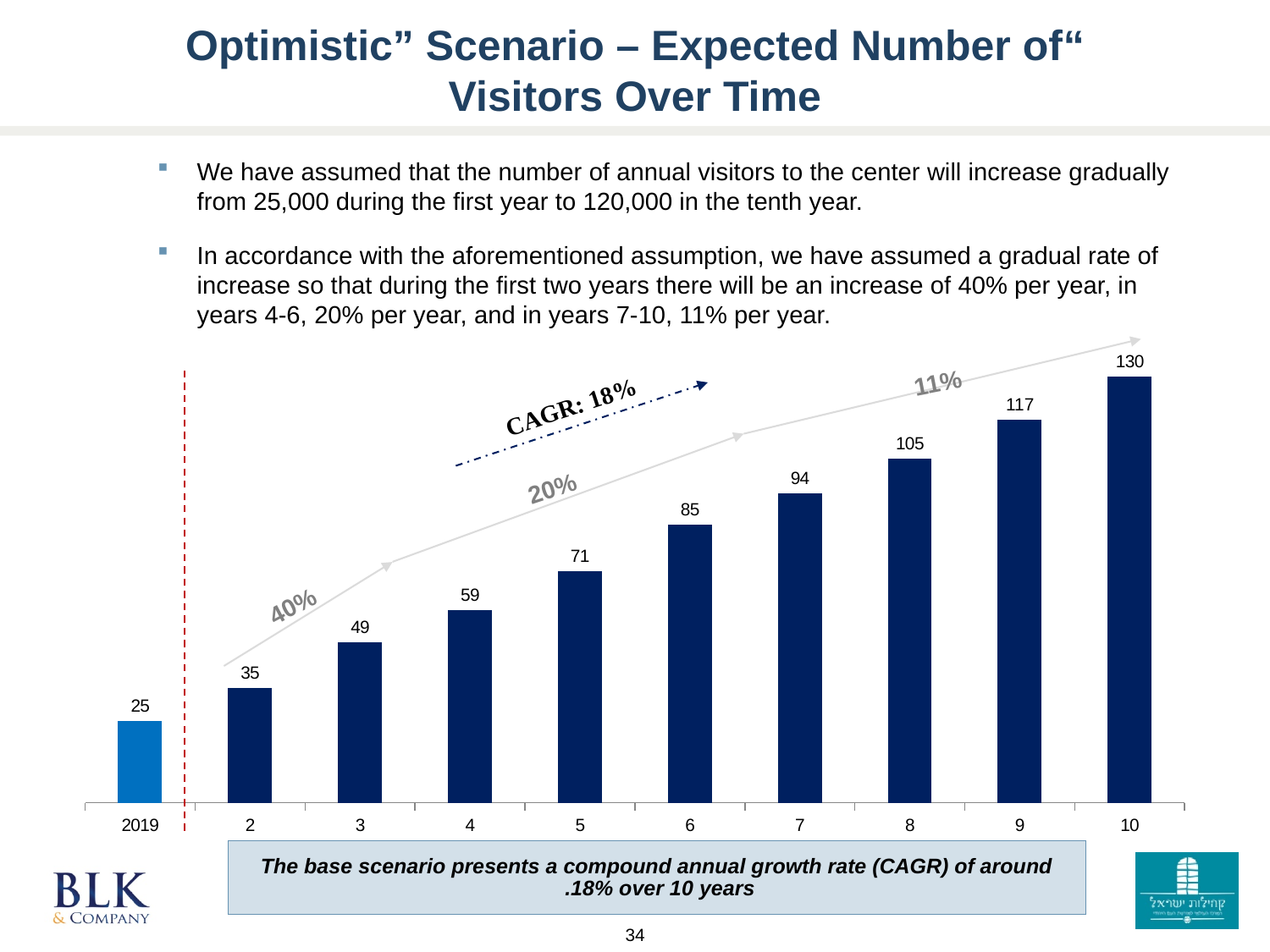
What value is shown for year 5? 71 What CAGR is labelled on the dashed arrow above the bars? CAGR: 18% Which year has the highest value on the chart? 10 Which is larger, the value for year 4 or the value for year 3? Year 4 What is the expected number of visitors (in thousands) shown for 2019? 25 Which category has the lowest value on the chart? 2019 Do the values rise or fall from 2019 to year 10? Rise What is the difference between the value for year 10 and the value for 2019? 105 What value is shown for year 8? 105 What kind of chart is shown on the slide? Bar chart How many bars are plotted on the chart? 10 What is the difference between the values for year 7 and year 6? 9